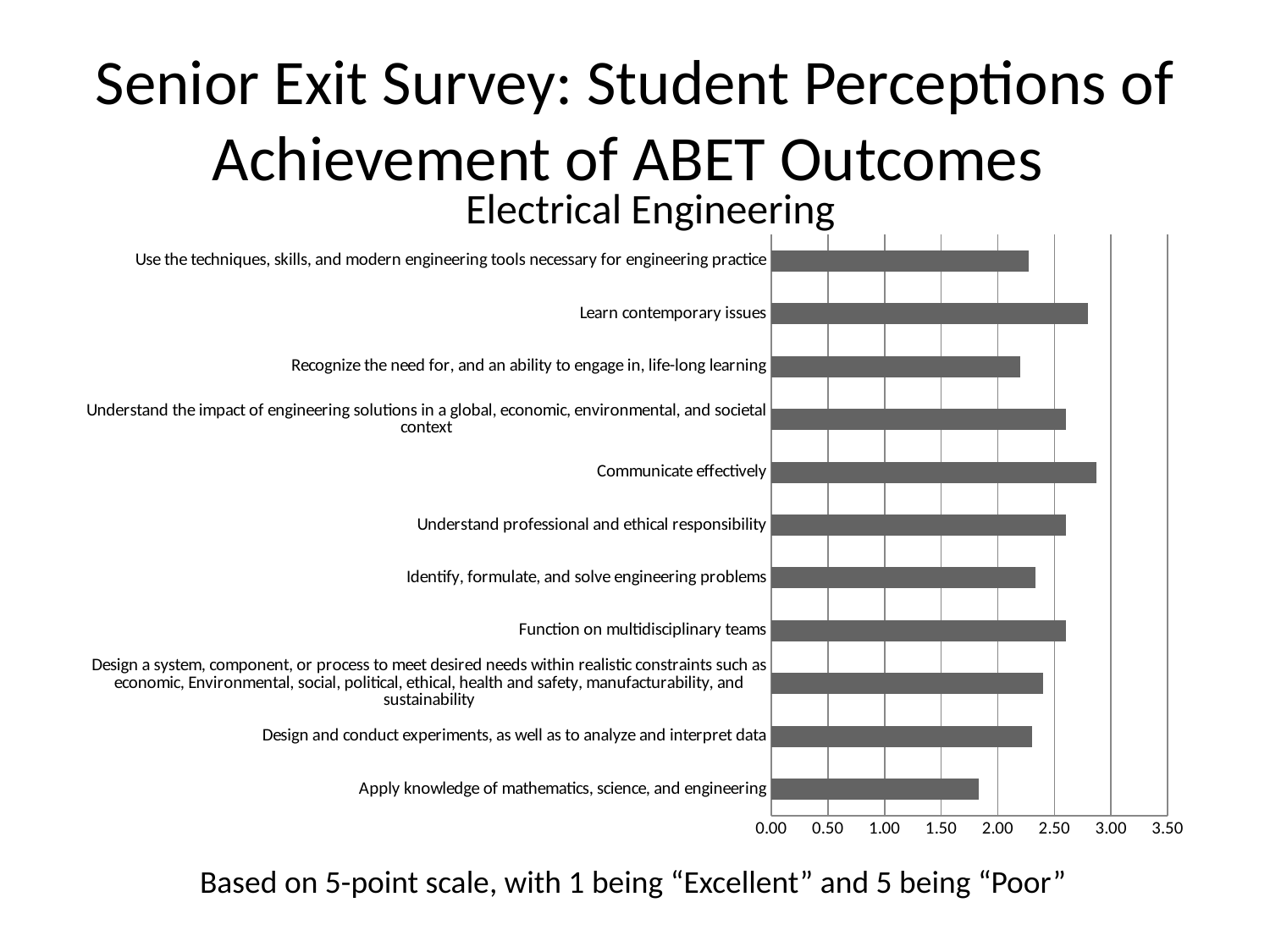
Is the value for "Identify, formulate, and solve engineering problems" greater or less than 2.50? less Is the value for "Communicate effectively" greater or less than 2.50? greater What is the title shown directly above the chart? Electrical Engineering Which has the larger value: "Learn contemporary issues" or "Recognize the need for, and an ability to engage in, life-long learning"? Learn contemporary issues Is the value for "Recognize the need for, and an ability to engage in, life-long learning" greater or less than 2.50? less What is the highest value shown on the horizontal axis of the chart? 3.50 Which outcome has the lowest value in the chart? Apply knowledge of mathematics, science, and engineering How many outcome categories are plotted in the chart? 11 Which has the larger value: "Communicate effectively" or "Apply knowledge of mathematics, science, and engineering"? Communicate effectively What kind of chart is shown on the slide? bar chart